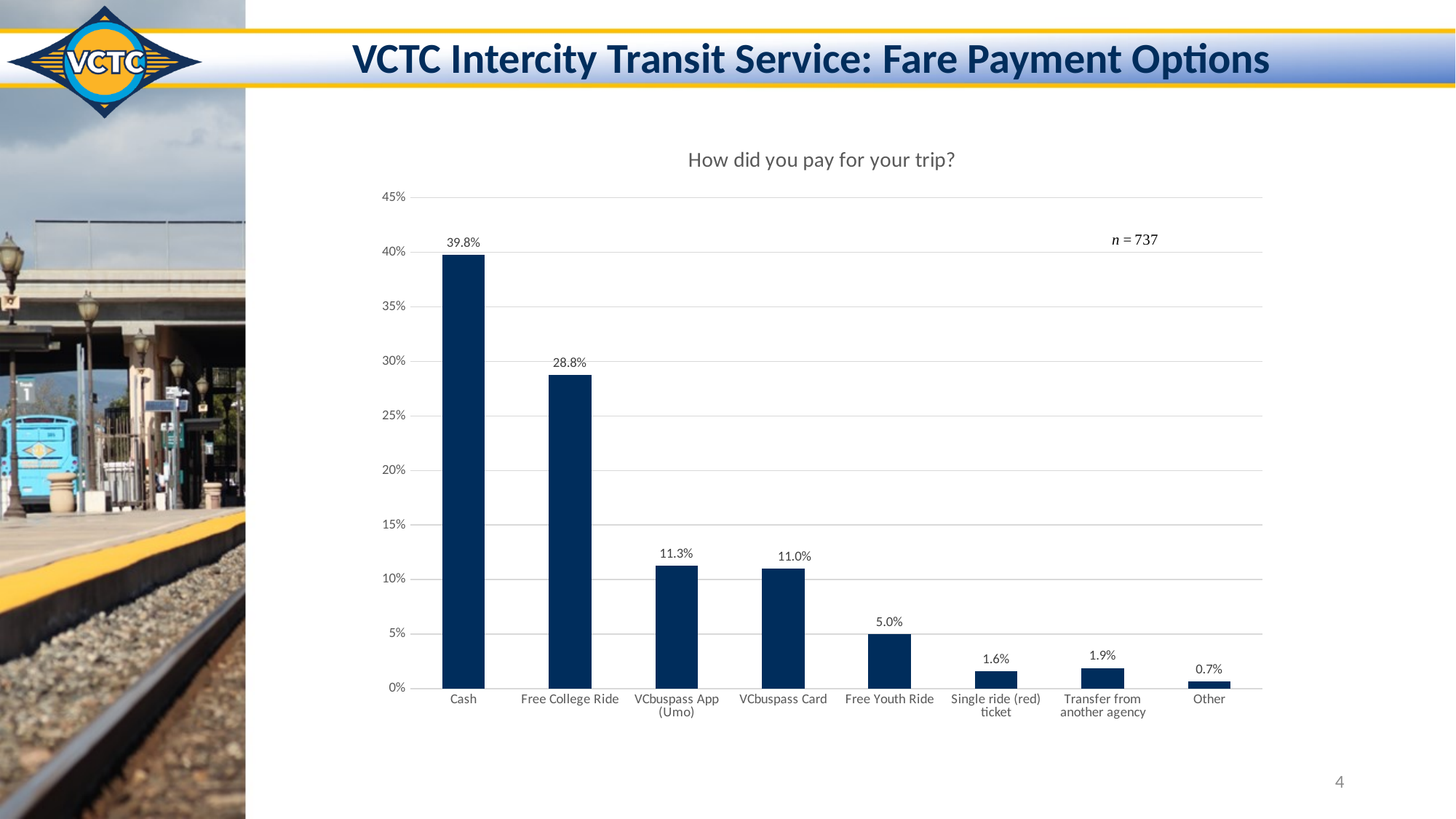
What is the value shown for Free College Ride? 28.8% What is the sample size (n) noted on the chart? 737 What is the difference between the Cash and Free College Ride percentages? 11.0% What kind of chart is shown on the slide? Bar chart What is the value for Transfer from another agency? 1.9% Which fare payment option has the lowest percentage? Other How many fare payment categories are shown on the x axis? 8 What percentage of respondents paid for their trip with Cash? 39.8% Which fare payment option has the highest percentage? Cash Is the value for VCbuspass Card greater or less than 10%? greater Which is larger, the value for Free Youth Ride or the value for Single ride (red) ticket? Free Youth Ride What percentage is shown for VCbuspass App (Umo)? 11.3%